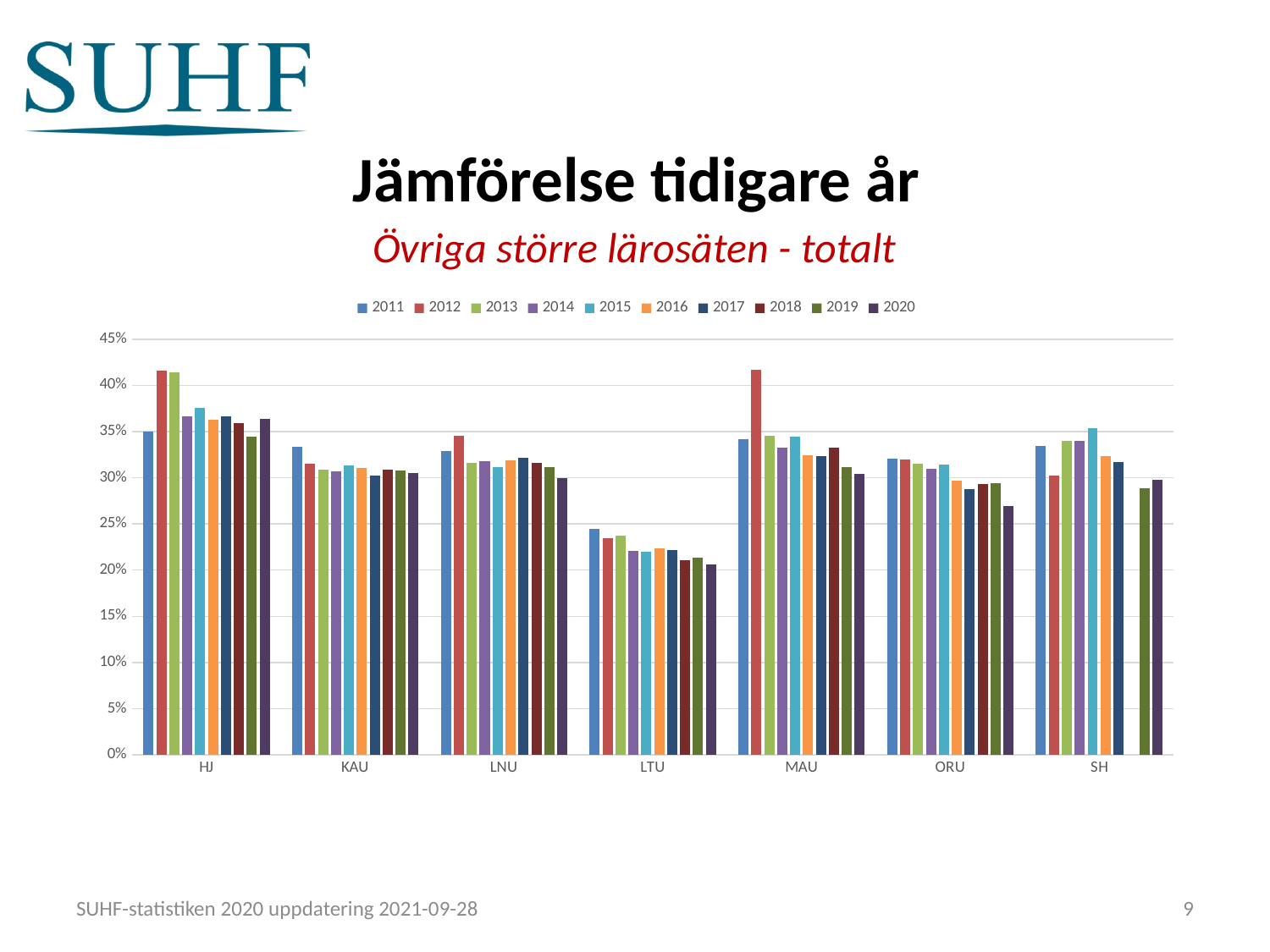
Which institution has the lowest values across all years in the chart? LTU How many series does the chart legend list? 10 For ORU, which year has the lowest value? 2020 Is the value for LTU in 2020 greater or less than 25%? less How many institutions (categories) are shown on the x axis of the chart? 7 Is the value for MAU in 2012 greater or less than 40%? greater For MAU, which year has the highest value? 2012 Is the value for ORU in 2020 greater or less than 30%? less For KAU, which year has the highest value? 2011 Do the values for ORU generally rise or fall from 2011 to 2020? fall Which is larger: the 2012 value for HJ or the 2012 value for KAU? HJ What kind of chart is shown on the slide? bar chart